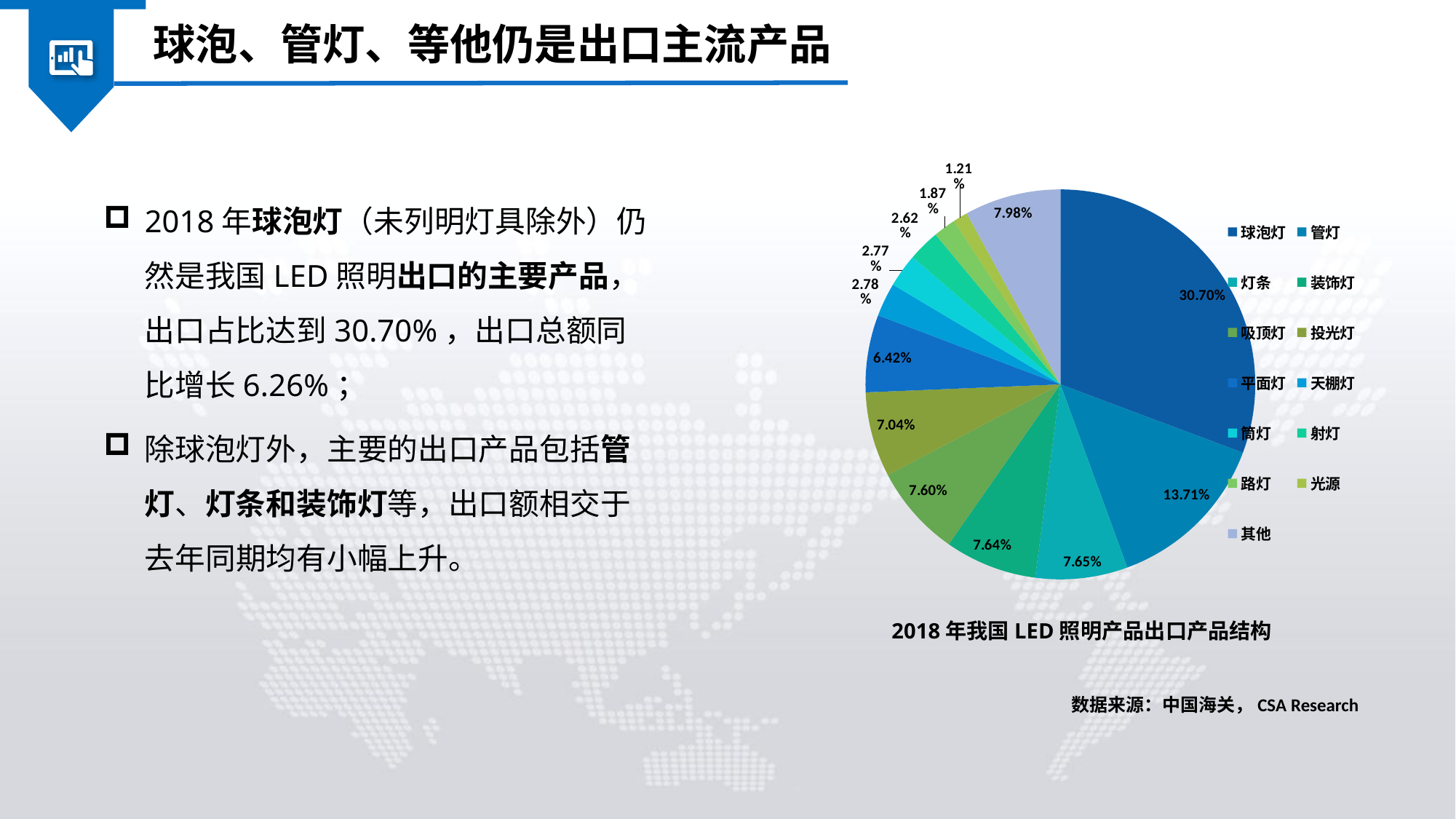
What share of the pie does 球泡灯 account for? 30.70% What kind of chart is shown on the slide? pie chart What is the value shown for 平面灯? 6.42% Which category has the smallest slice of the pie? 光源 What is the value shown for 管灯? 13.71% What is the value shown for 光源? 1.21% What is the title of the pie chart? 2018年我国LED照明产品出口产品结构 Which is larger, the share of 其他 or the share of 投光灯? 其他 What is the difference between the shares of 球泡灯 and 管灯? 16.99% What is the value shown for 其他? 7.98% Which category has the largest slice of the pie? 球泡灯 How many categories does the pie chart have? 13